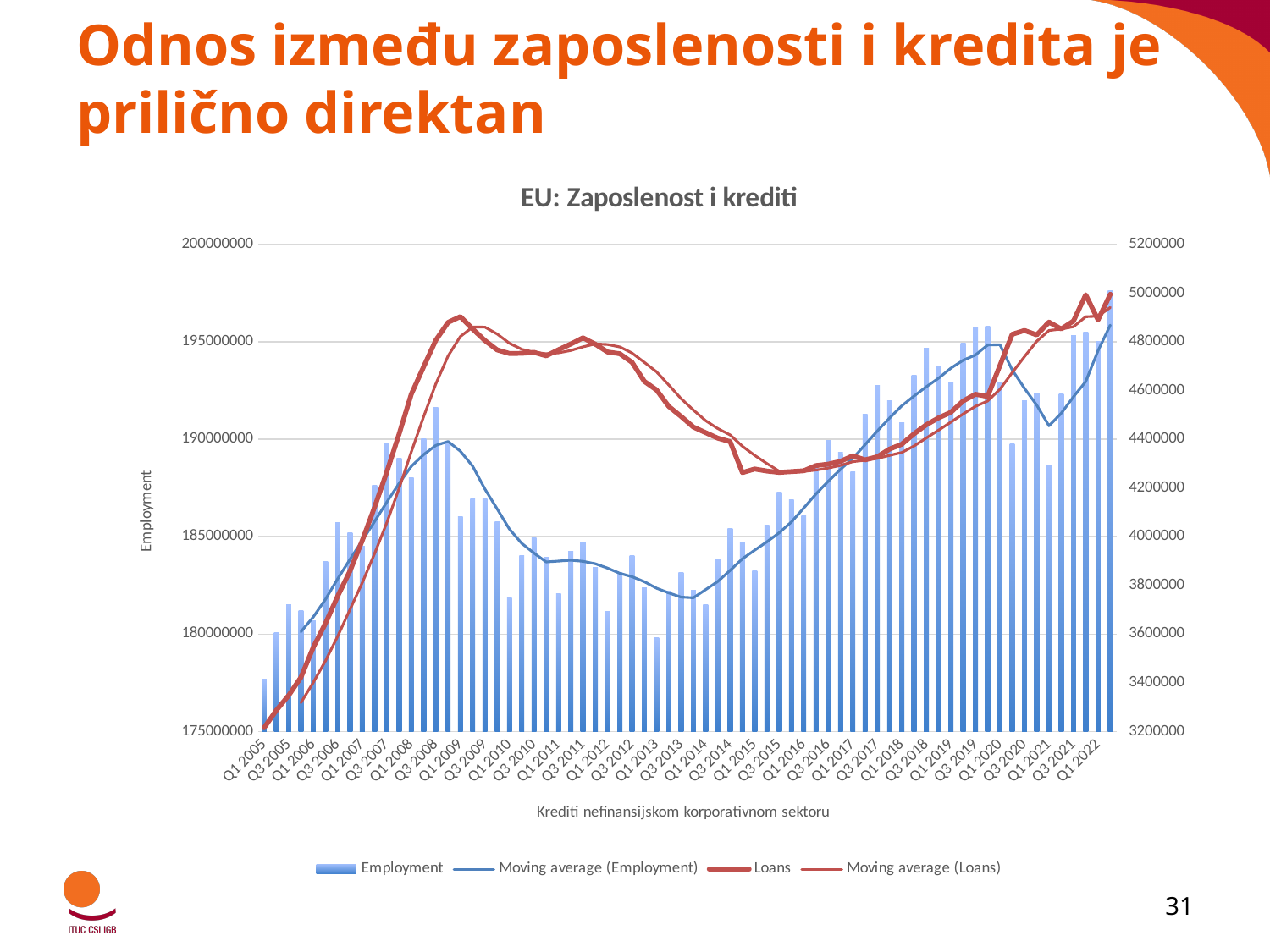
Does the Loans line rise or fall from Q1 2009 to Q1 2015? fall Is the Employment value for Q3 2020 greater or less than 190000000? greater What kind of chart is used to show the Employment series? bar chart Do the Employment bars rise or fall from Q1 2005 to Q1 2009? rise How many series does the chart legend list? 4 Is the Loans value for Q1 2022 greater or less than 4800000 on the right axis? greater Is the Employment value for Q1 2009 greater or less than 190000000? less What is the title of the left vertical axis? Employment What is the title of the chart? EU: Zaposlenost i krediti Which quarter has the lowest Employment bar? Q1 2005